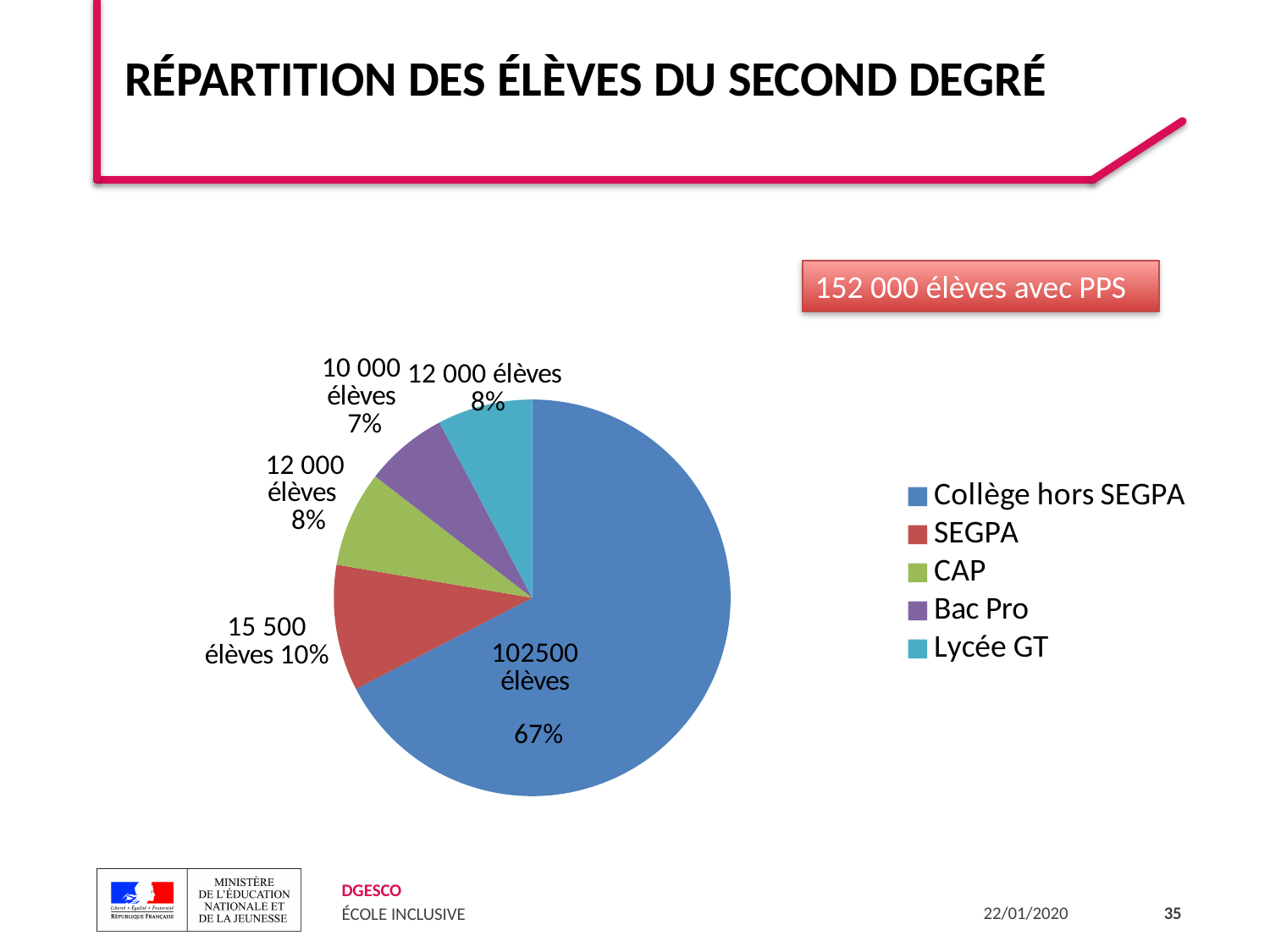
How many élèves are shown for SEGPA? 15 500 élèves How many élèves are shown for Bac Pro? 10 000 élèves How many élèves are shown for Collège hors SEGPA? 102500 élèves Which is larger, the SEGPA slice or the CAP slice? SEGPA What is the title of the slide containing the pie chart? RÉPARTITION DES ÉLÈVES DU SECOND DEGRÉ What is the difference in élèves between SEGPA and Bac Pro? 5 500 élèves Which category has the largest slice of the pie? Collège hors SEGPA Which category has the smallest slice of the pie? Bac Pro What share of the pie does Collège hors SEGPA represent? 67% What kind of chart is shown on the slide? pie chart How many categories does the pie chart have? 5 What share of the pie does Bac Pro represent? 7%